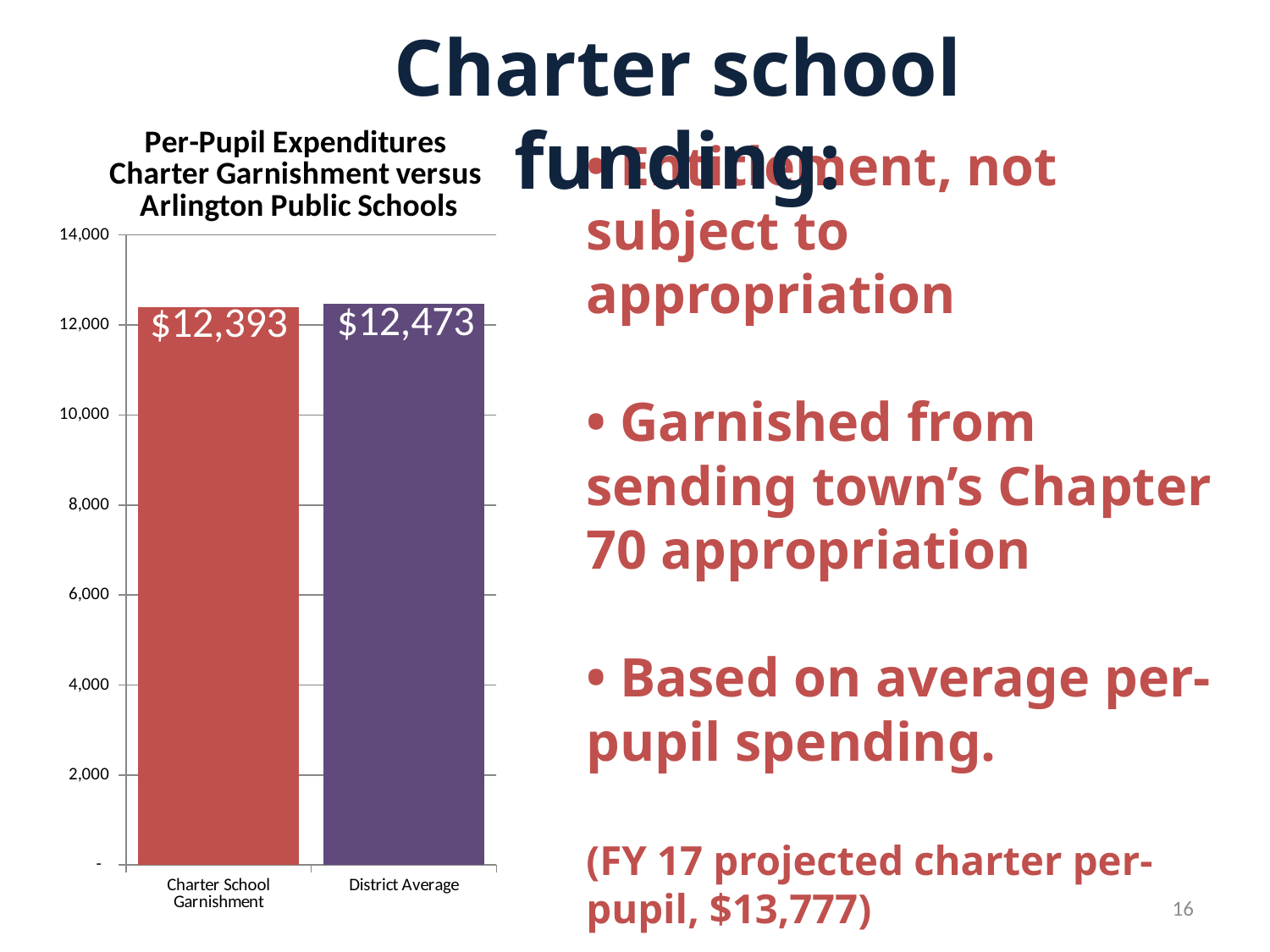
What is the title of the chart? Per-Pupil Expenditures Charter Garnishment versus Arlington Public Schools How many categories are shown in the chart? 2 Which category has the higher value, Charter School Garnishment or District Average? District Average What is the difference between the District Average and the Charter School Garnishment values? $80 What kind of chart is shown on the slide? bar chart What colour is the District Average bar? purple What is the value for District Average? $12,473 Is the value for District Average greater or less than 14,000? less Which category has the lowest value? Charter School Garnishment What is the value for Charter School Garnishment? $12,393 Is the value for Charter School Garnishment greater or less than 12,000? greater What is the highest value shown on the vertical axis? 14,000